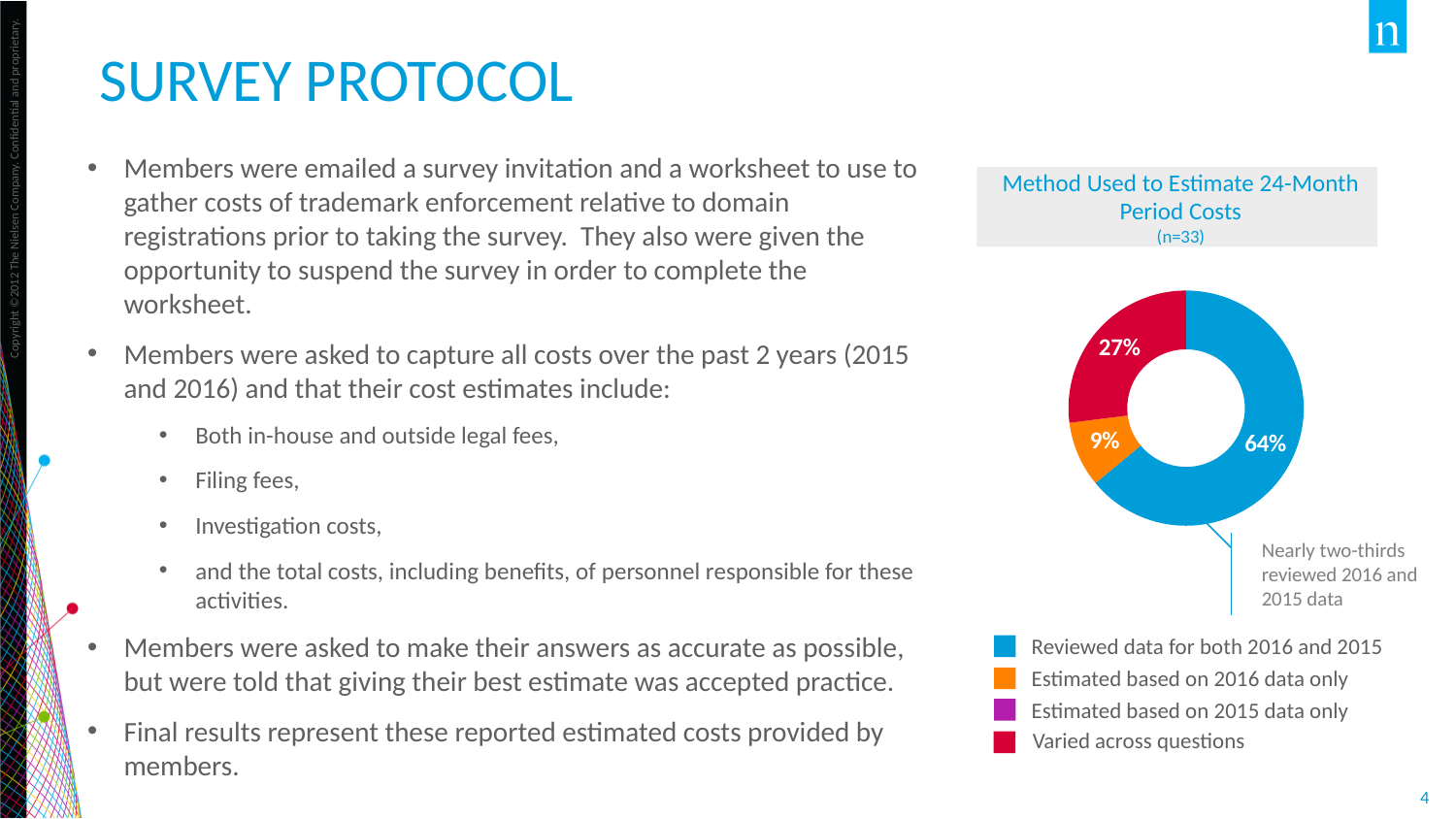
What is the title of the chart? Method Used to Estimate 24-Month Period Costs What kind of chart is shown on the slide? Pie chart (donut) How many slices of the pie have a percentage label printed on them? 3 What is the sample size (n) shown under the chart title? n=33 What percentage of respondents varied across questions? 27% What percentage of respondents reviewed data for both 2016 and 2015? 64% Which category has the largest share of the pie? Reviewed data for both 2016 and 2015 How many entries does the chart legend list? 4 Which labelled slice has the smallest share of the pie? Estimated based on 2016 data only What is the difference in percentage points between 'Reviewed data for both 2016 and 2015' and 'Varied across questions'? 37 What percentage of respondents estimated based on 2016 data only? 9% Which is larger: the share for 'Varied across questions' or the share for 'Estimated based on 2016 data only'? Varied across questions